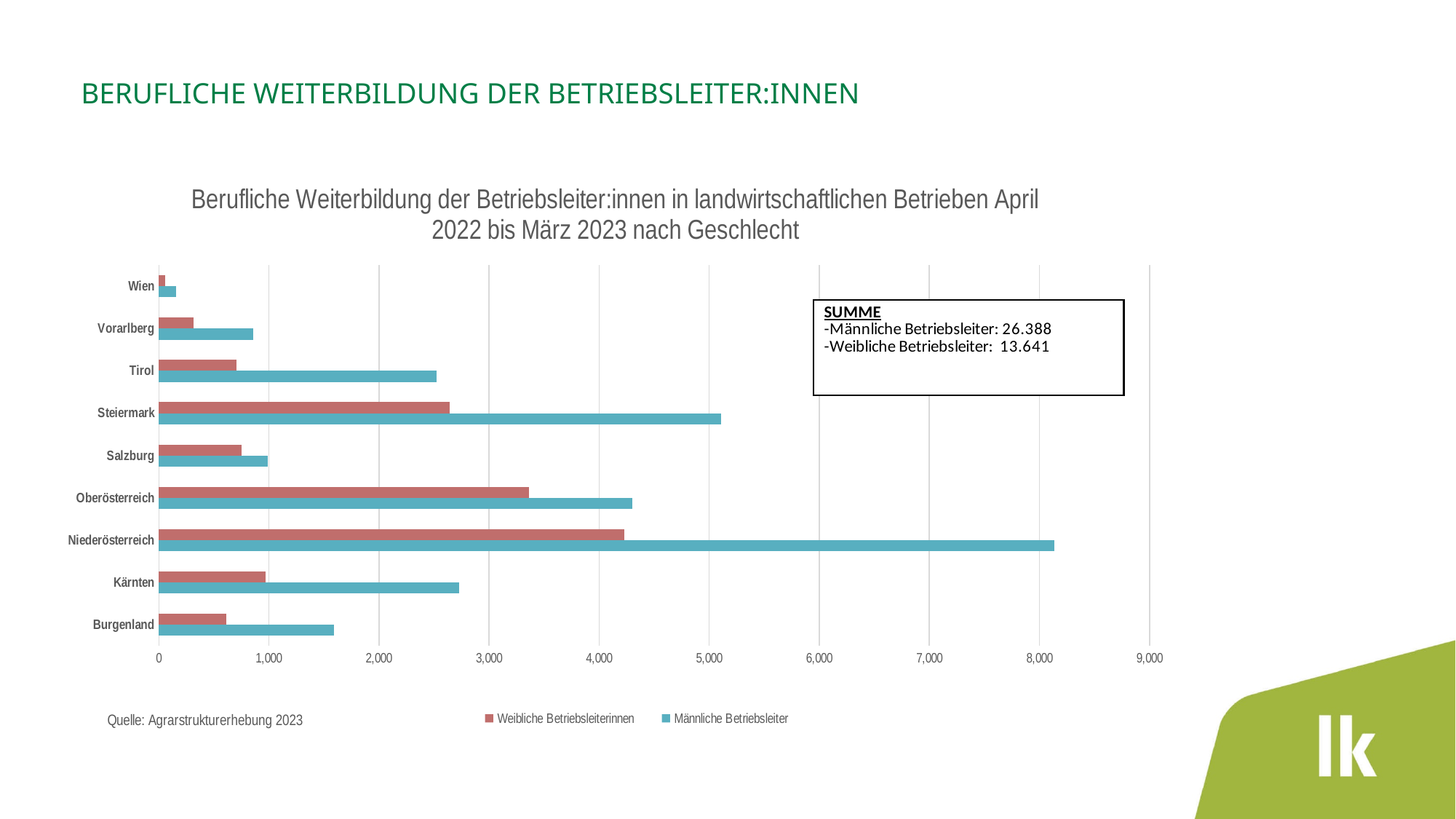
What kind of chart is shown on the slide? bar chart Is the value for Männliche Betriebsleiter in Niederösterreich greater or less than 7,000? greater What source is cited below the chart? Agrarstrukturerhebung 2023 How many series does the chart legend list? 2 Which federal state has the highest value for Weibliche Betriebsleiterinnen? Niederösterreich Which federal state has the lowest value for Weibliche Betriebsleiterinnen? Wien Is the value for Männliche Betriebsleiter in Kärnten greater or less than 3,000? less How many federal states (categories) are shown on the chart? 9 Is the value for Männliche Betriebsleiter in Vorarlberg greater or less than 1,000? less Which is larger: the Männliche Betriebsleiter value for Steiermark or for Oberösterreich? Steiermark Which federal state has the highest value for Männliche Betriebsleiter? Niederösterreich